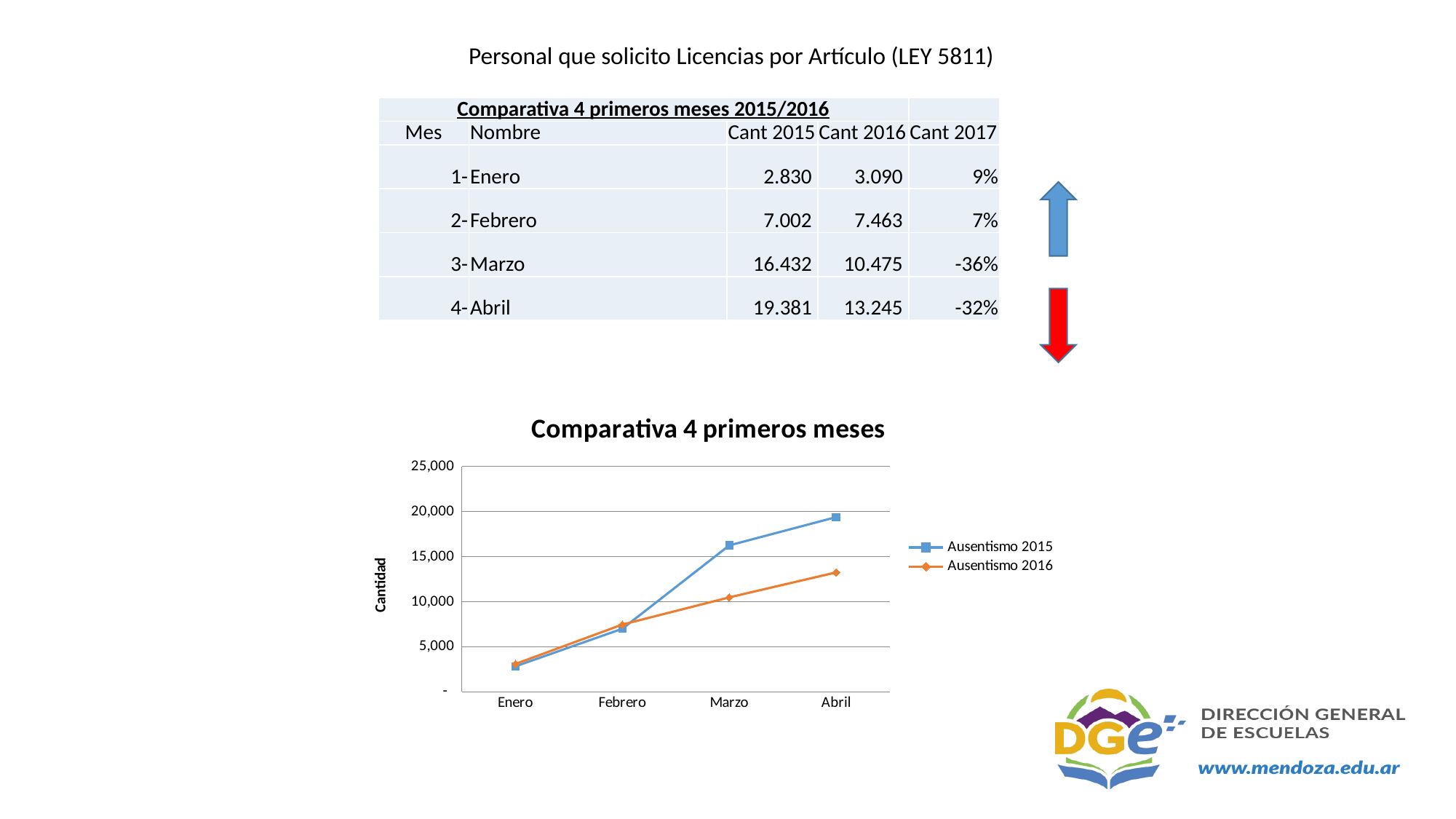
What is the label on the vertical axis of the chart? Cantidad In Marzo, which series has the larger value, Ausentismo 2015 or Ausentismo 2016? Ausentismo 2015 Is the value for Ausentismo 2016 in Marzo greater or less than 15,000? less How many series does the legend of the chart list? 2 Is the value for Ausentismo 2016 in Enero greater or less than 5,000? less Does the Ausentismo 2015 line rise or fall from Enero to Abril? rise How many months are plotted along the x axis of the chart? 4 What kind of chart is shown on the slide? line chart In which month does the Ausentismo 2015 series reach its highest value? Abril Is the value for Ausentismo 2015 in Abril greater or less than 15,000? greater What is the title of the chart? Comparativa 4 primeros meses In which month is the Ausentismo 2016 series lowest? Enero